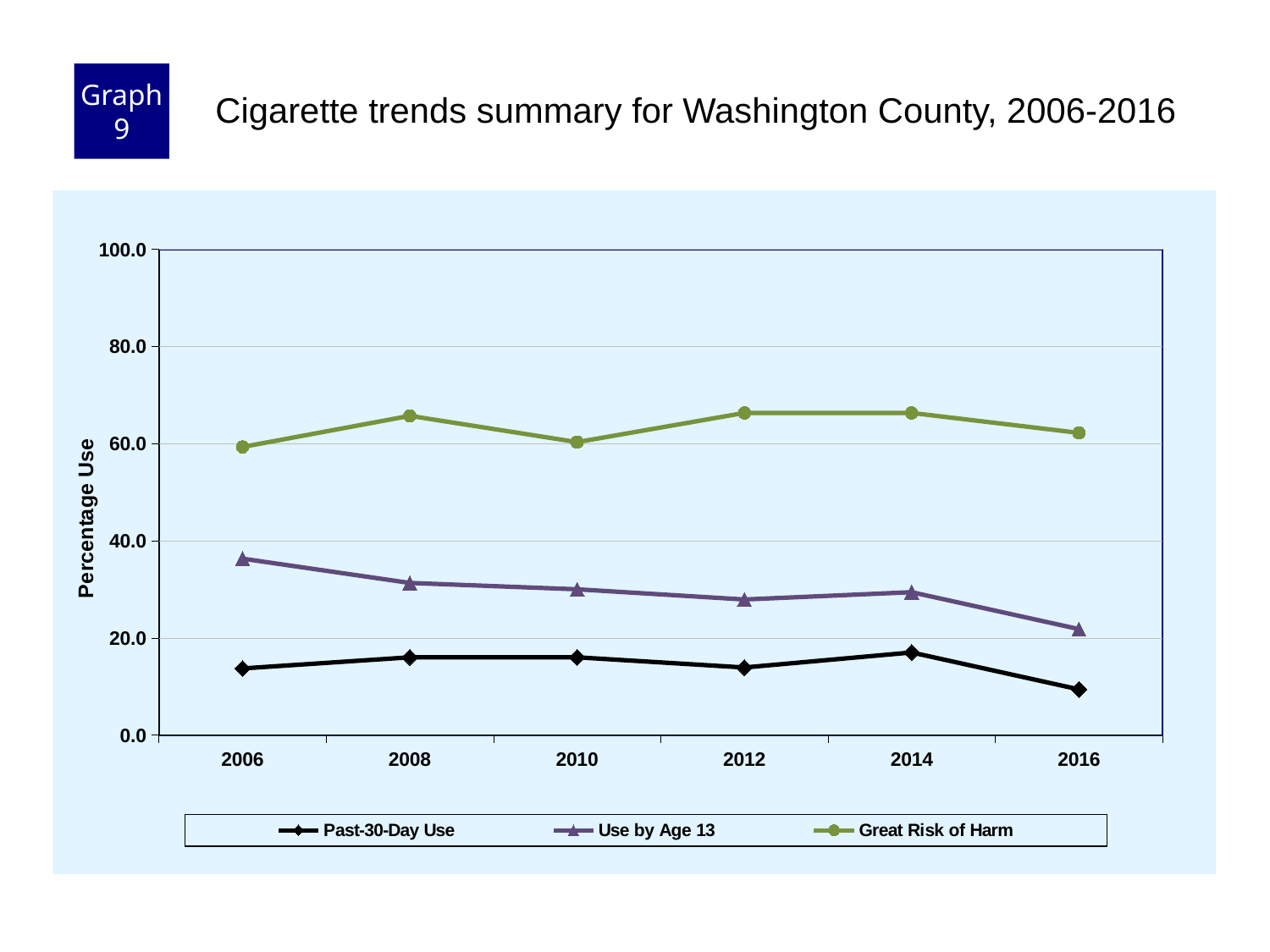
Is the value for Use by Age 13 in 2006 greater or less than 40.0? less Is the value for Past-30-Day Use in 2016 greater or less than 20.0? less How many series does the legend list? 3 Which series has the highest values across all years? Great Risk of Harm How many years are plotted along the x axis? 6 Which is larger in 2016: Use by Age 13 or Past-30-Day Use? Use by Age 13 Is the value for Great Risk of Harm in 2008 greater or less than 60.0? greater Does Use by Age 13 generally rise or fall from 2006 to 2016? fall What kind of chart is shown on the slide? line chart In which year is Use by Age 13 at its lowest? 2016 Which series has the lowest values across all years? Past-30-Day Use